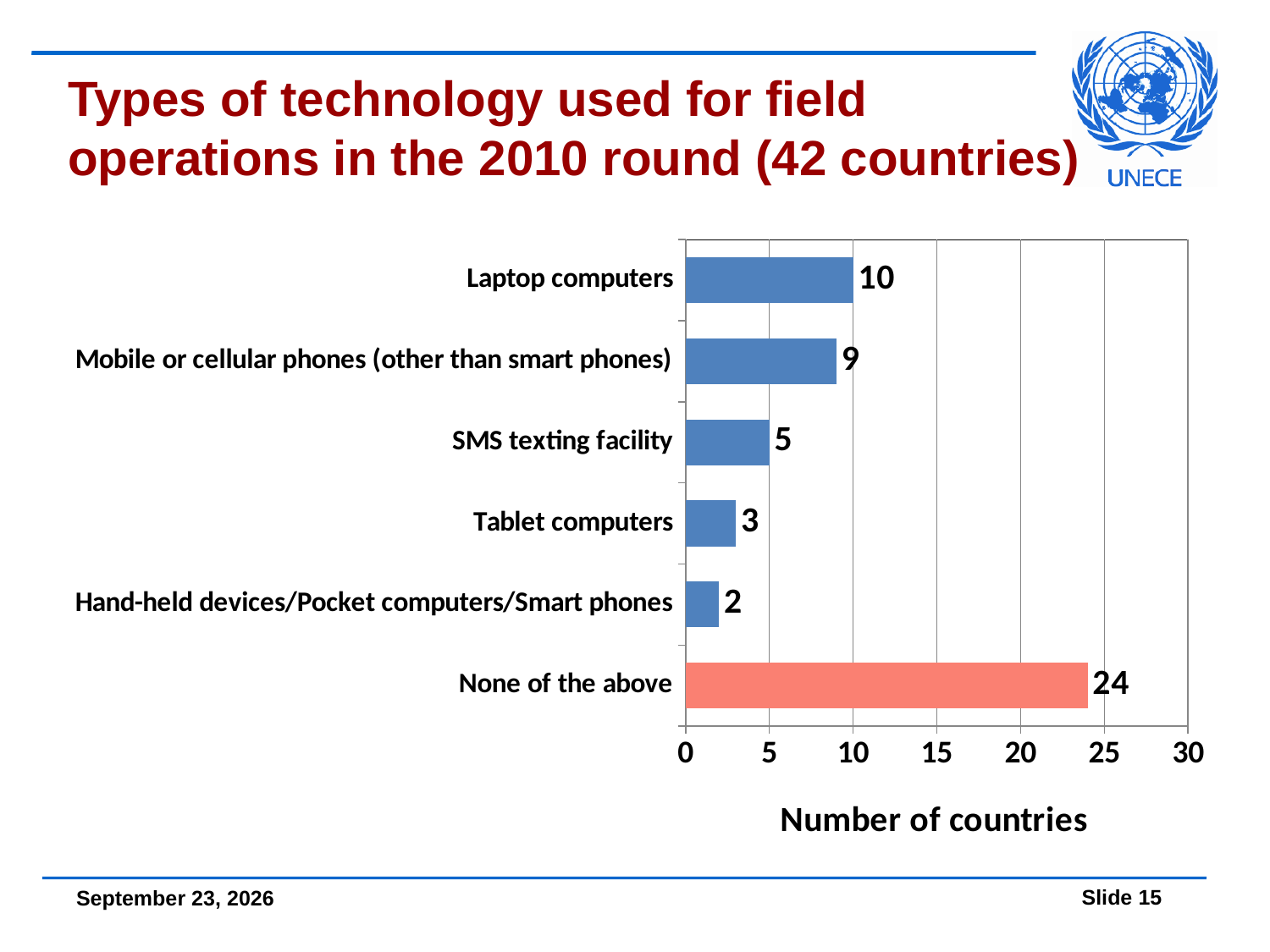
What kind of chart is shown on the slide? Bar chart What is the label of the horizontal axis? Number of countries Which category has the highest number of countries? None of the above Which has more countries: Mobile or cellular phones (other than smart phones) or Tablet computers? Mobile or cellular phones (other than smart phones) What is the value for SMS texting facility? 5 How many categories are shown in the chart? 6 Is the value for Mobile or cellular phones (other than smart phones) greater or less than 10? less How many countries used laptop computers for field operations? 10 What is the difference between the number of countries for 'None of the above' and for laptop computers? 14 How many countries reported 'None of the above'? 24 What is the value for Hand-held devices/Pocket computers/Smart phones? 2 Which category has the lowest number of countries? Hand-held devices/Pocket computers/Smart phones